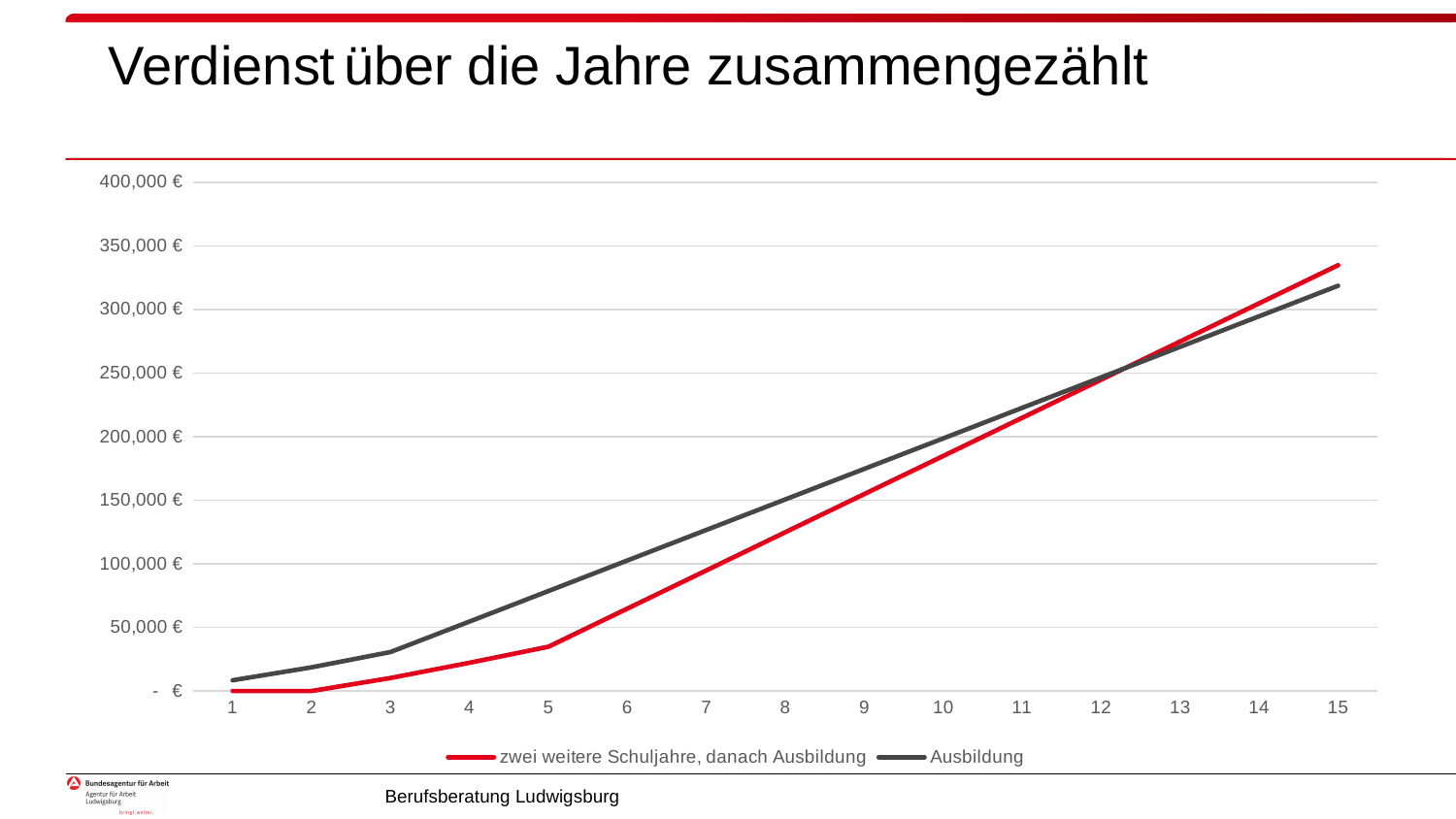
Is the value for 'zwei weitere Schuljahre, danach Ausbildung' at year 5 greater or less than 50,000 €? less How many series does the legend list? 2 Do the values of the 'Ausbildung' series rise or fall from year 1 to year 15? rise At year 5, which series has the larger value: 'Ausbildung' or 'zwei weitere Schuljahre, danach Ausbildung'? Ausbildung Is the value for 'zwei weitere Schuljahre, danach Ausbildung' at year 10 greater or less than 200,000 €? less At year 15, which series has the larger value: 'Ausbildung' or 'zwei weitere Schuljahre, danach Ausbildung'? zwei weitere Schuljahre, danach Ausbildung What kind of chart is shown on the slide? line chart Is the value for 'Ausbildung' at year 15 greater or less than 300,000 €? greater Which series is drawn in red? zwei weitere Schuljahre, danach Ausbildung How many points are plotted along the x axis for each series? 15 What is the title of the chart? Verdienst über die Jahre zusammengezählt